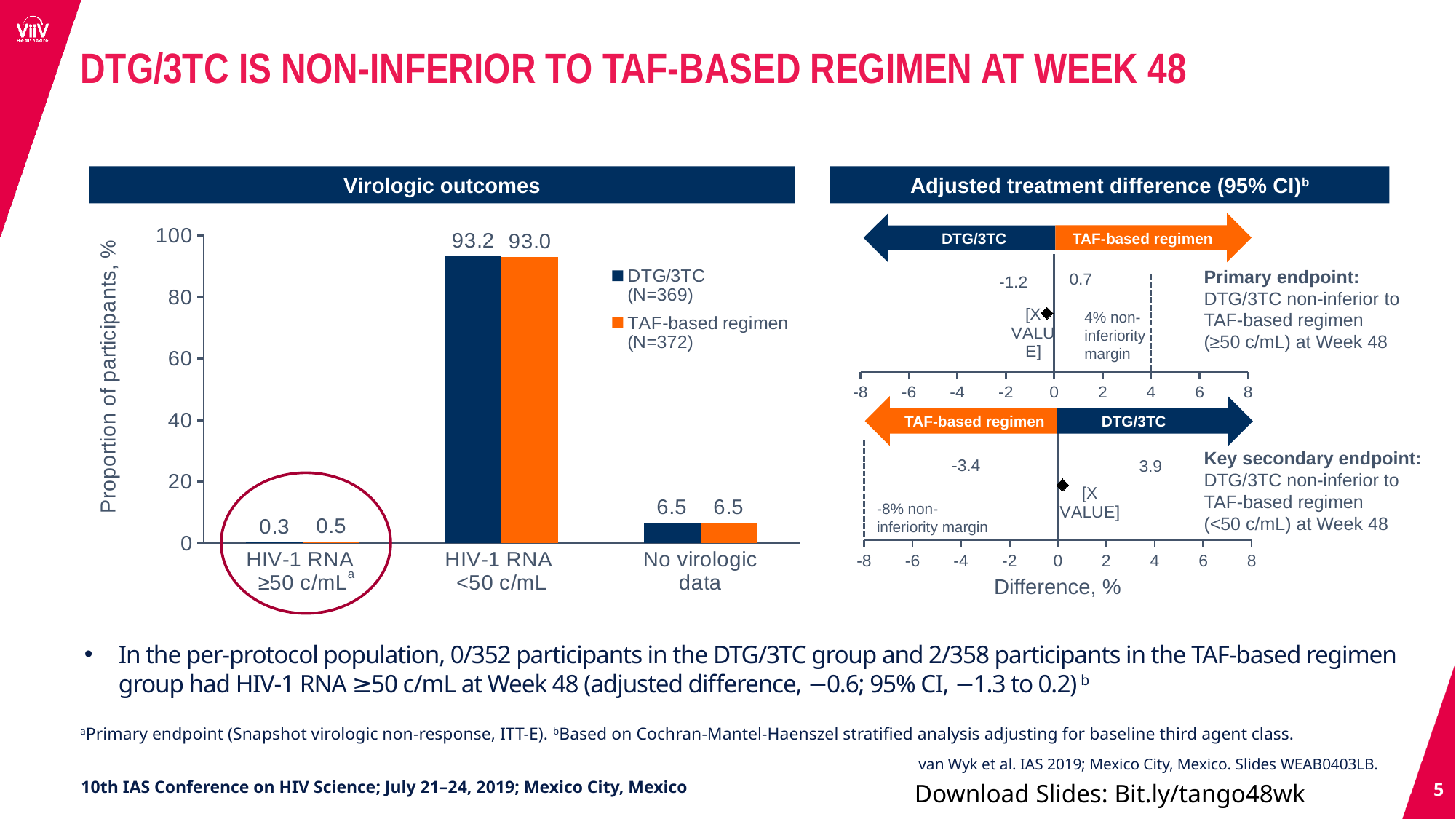
In the Virologic outcomes chart, which series has the larger value in the HIV-1 RNA ≥50 c/mL category? TAF-based regimen In the Virologic outcomes chart, what is the value for DTG/3TC in the No virologic data category? 6.5 In the Virologic outcomes chart, which category has the lowest value for DTG/3TC? HIV-1 RNA ≥50 c/mL In the Virologic outcomes chart, what is the value for the TAF-based regimen in the HIV-1 RNA ≥50 c/mL category? 0.5 In the Virologic outcomes chart, what is the value for DTG/3TC in the HIV-1 RNA <50 c/mL category? 93.2 In the Adjusted treatment difference chart, what is the x-axis title? Difference, % In the Virologic outcomes chart, what is the sample size (N) shown in the legend for the TAF-based regimen? N=372 In the Virologic outcomes chart, how many categories are shown on the x axis? 3 What kind of chart is the Virologic outcomes chart? Bar chart In the Virologic outcomes chart, which category has the highest values for both series? HIV-1 RNA <50 c/mL In the Virologic outcomes chart, what is the difference between the DTG/3TC and TAF-based regimen values in the HIV-1 RNA <50 c/mL category? 0.2 In the Virologic outcomes chart, how many series does the legend list? 2